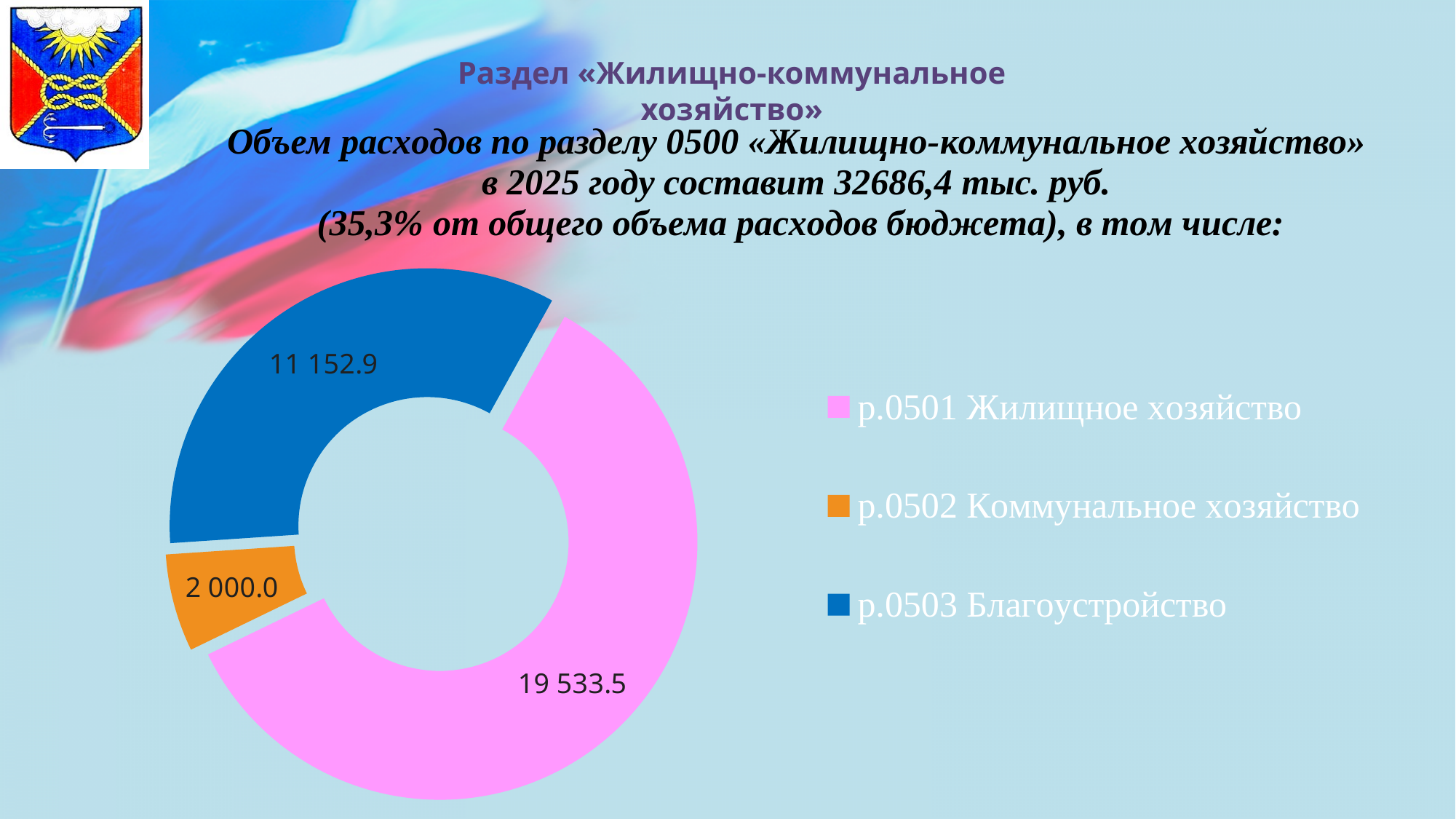
What is the value for р.0503 Благоустройство? 11 152.9 What is the total of all three segments in the chart? 32 686.4 What colour is the segment for р.0502 Коммунальное хозяйство? Orange What is the difference between the values for р.0501 Жилищное хозяйство and р.0503 Благоустройство? 8 380.6 How many categories does the chart show? 3 Which category has the smallest value? р.0502 Коммунальное хозяйство What type of chart is shown on the slide? Doughnut (pie) chart What is the value for р.0502 Коммунальное хозяйство? 2 000.0 What is the value for р.0501 Жилищное хозяйство? 19 533.5 What is the difference between the values for р.0503 Благоустройство and р.0502 Коммунальное хозяйство? 9 152.9 Which category has the largest value? р.0501 Жилищное хозяйство Which is larger: the value for р.0503 Благоустройство or р.0502 Коммунальное хозяйство? р.0503 Благоустройство